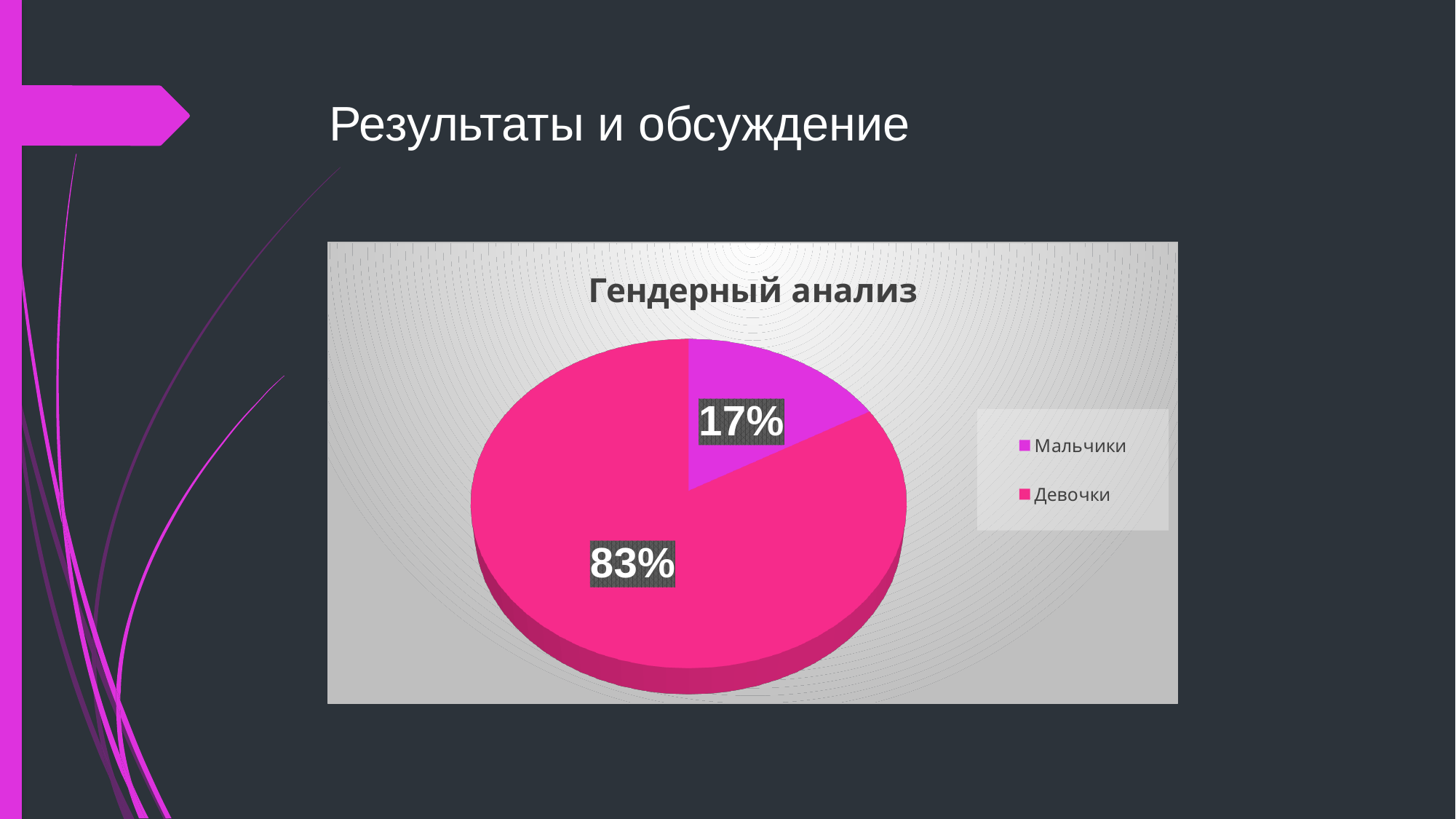
What kind of chart is shown on the slide? pie chart Which category has the smallest slice of the pie? Мальчики What share of the pie is Девочки? 83% Which is larger, the share for Мальчики or the share for Девочки? Девочки Which category has the largest slice of the pie? Девочки How many categories does the pie chart have? 2 How many entries does the legend list? 2 What is the difference in percentage points between Девочки and Мальчики? 66 What share of the pie is Мальчики? 17% Which category is shown in purple? Мальчики What is the title of the chart? Гендерный анализ